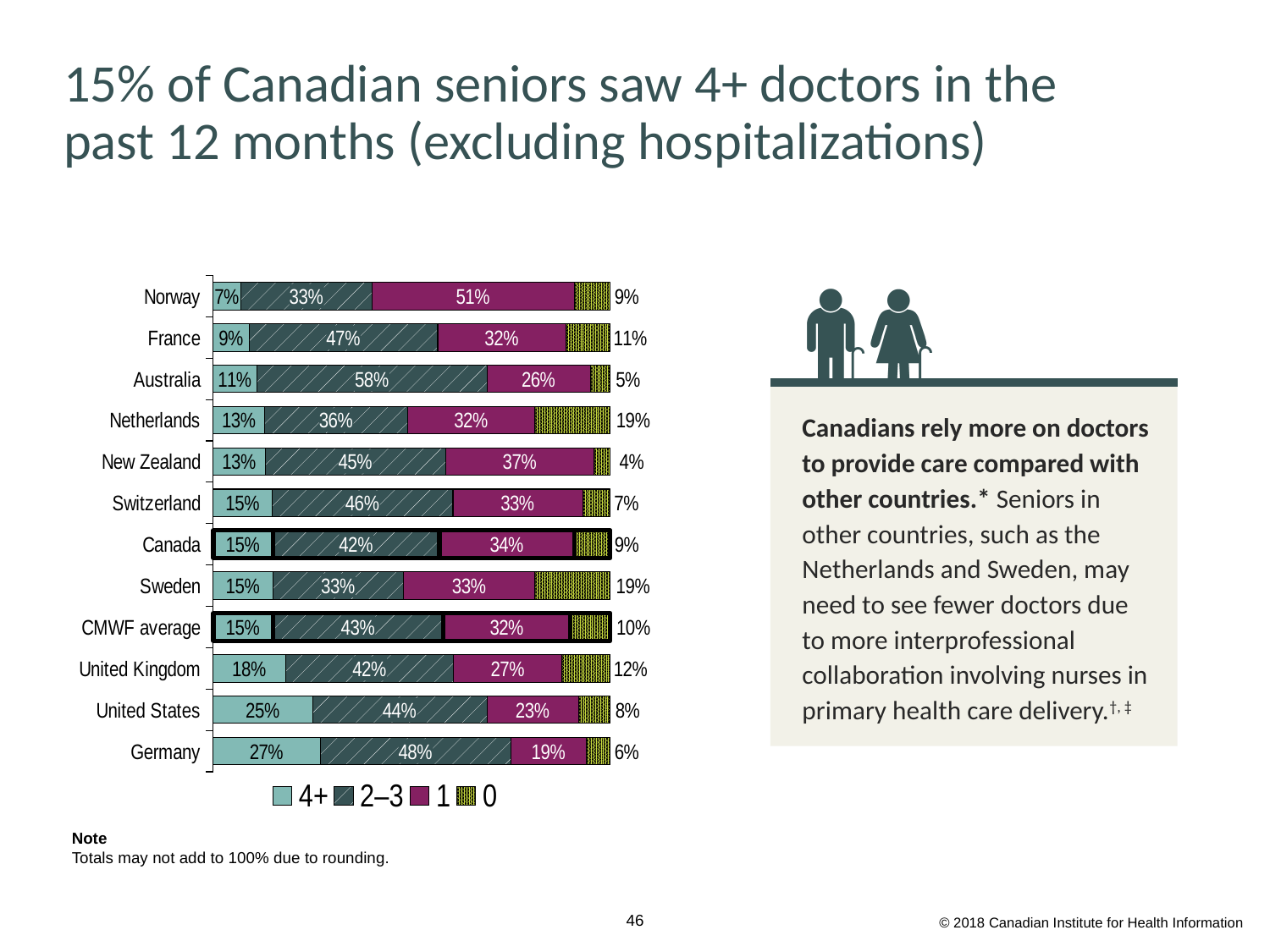
What type of chart is shown on the slide? Stacked bar chart Which country has the highest percentage of seniors who saw 4+ doctors? Germany How many countries or groups are shown on the chart? 12 Which country has the highest percentage of seniors who saw 2–3 doctors? Australia How many series does the legend list? 4 Which country has the lowest percentage of seniors who saw 4+ doctors? Norway What percentage of seniors in Germany saw 2–3 doctors? 48% What percentage of seniors in the Netherlands saw 0 doctors? 19% Which country has the lowest percentage of seniors who saw 0 doctors? New Zealand Which has a larger share of seniors who saw 1 doctor: Norway or Australia? Norway How many percentage points higher is the 4+ doctors share for Germany than for Canada? 12 percentage points What percentage of Canadian seniors saw 4+ doctors in the past 12 months? 15%